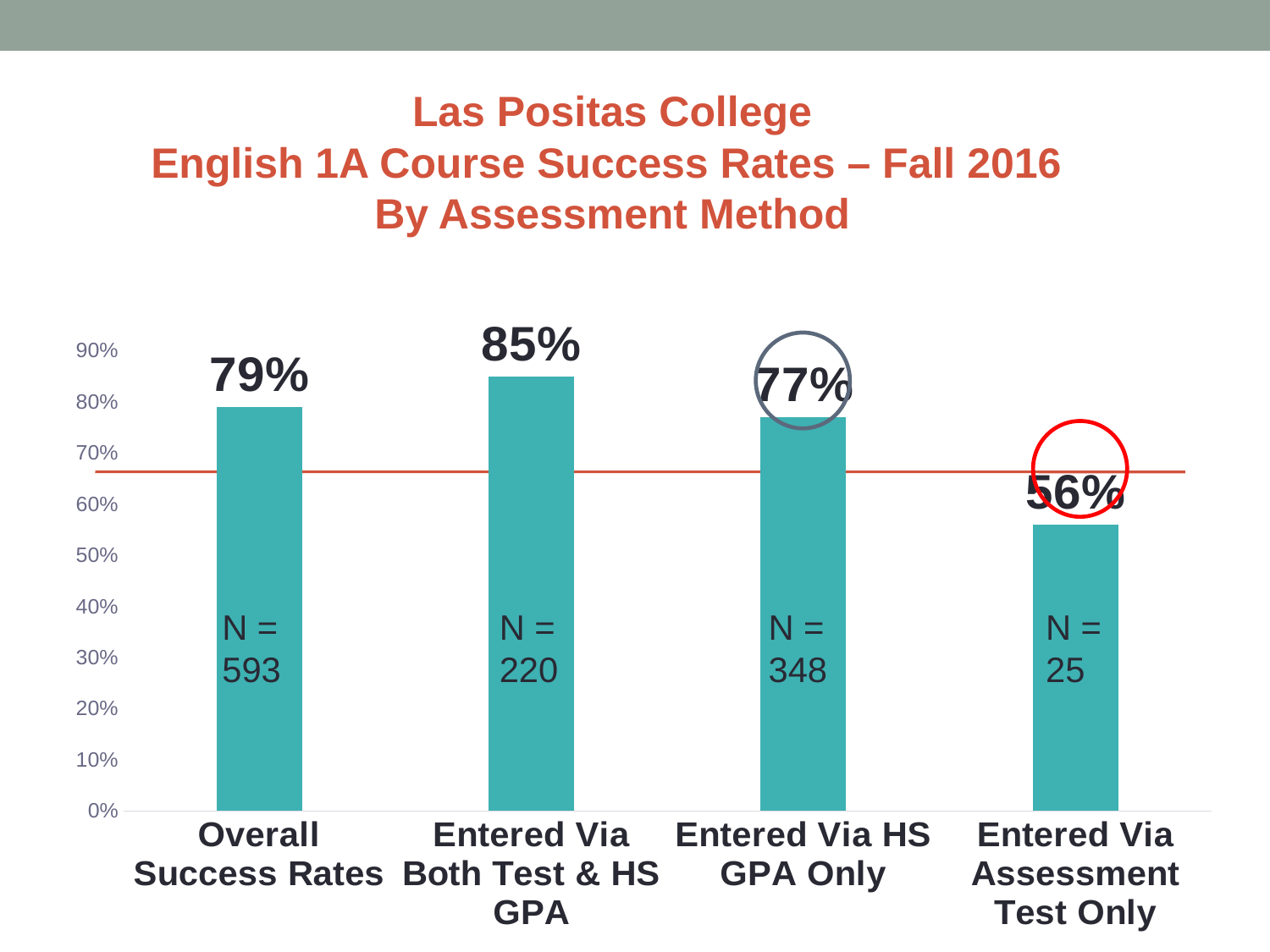
How many categories are shown on the chart? 4 Which category has the lowest success rate? Entered Via Assessment Test Only What is the N value for Entered Via Assessment Test Only? 25 What is the Overall Success Rate shown on the chart? 79% What is the success rate for Entered Via Assessment Test Only? 56% Is the value for Entered Via Assessment Test Only greater or less than 60%? less What kind of chart is shown on the slide? bar chart What is the difference between the success rates for Entered Via Both Test & HS GPA and Entered Via Assessment Test Only? 29% Which category has the highest success rate? Entered Via Both Test & HS GPA What is the success rate for Entered Via Both Test & HS GPA? 85% Which is larger, the success rate for Overall Success Rates or for Entered Via HS GPA Only? Overall Success Rates What is the N value for Entered Via HS GPA Only? 348